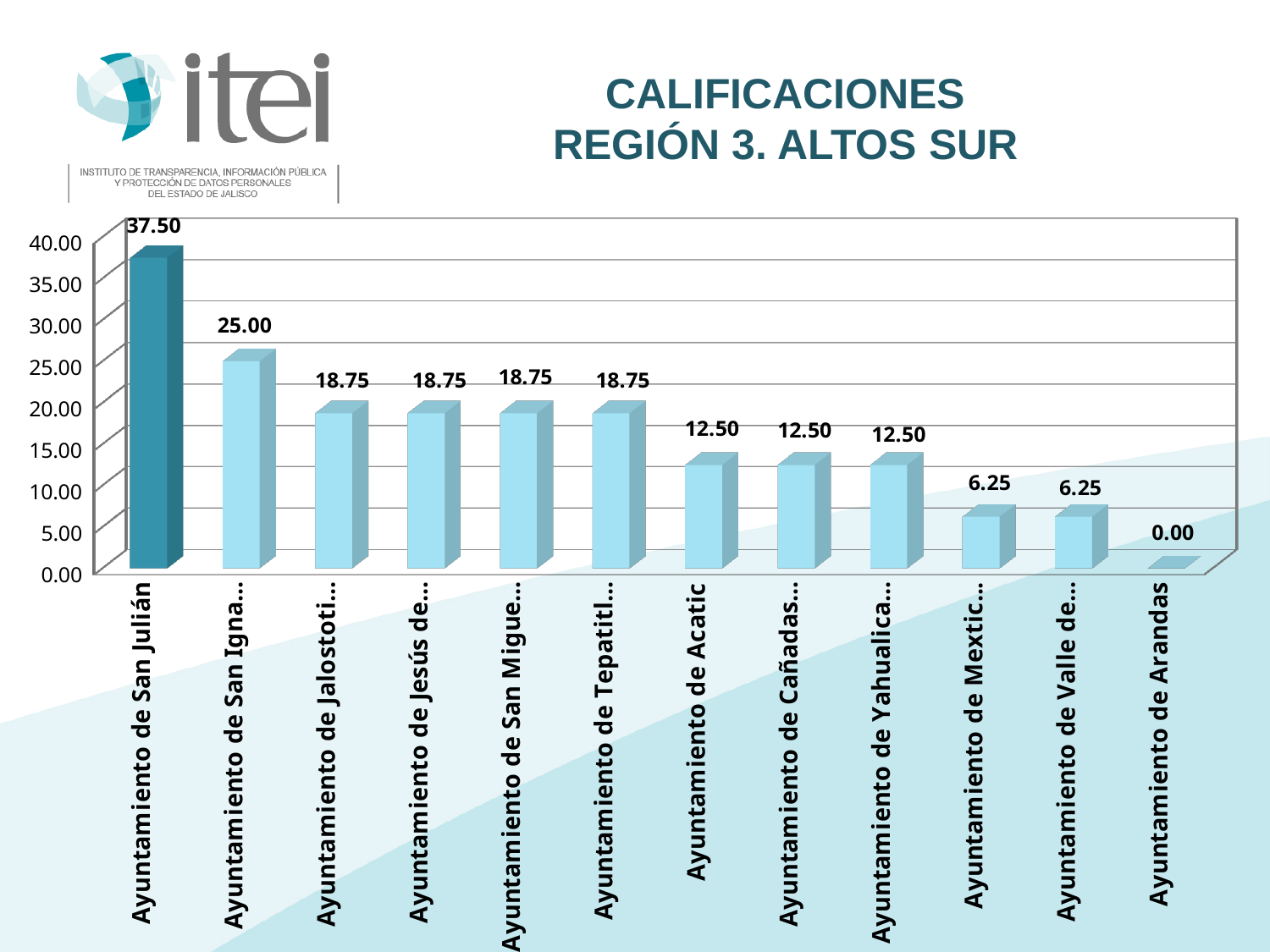
What is the difference between the values for Ayuntamiento de San Julián and Ayuntamiento de Acatic? 25.00 What is the value for Ayuntamiento de Acatic? 12.50 Which is larger, the value for Ayuntamiento de San Julián or the value for Ayuntamiento de Acatic? Ayuntamiento de San Julián What kind of chart is shown on the slide? bar chart What is the value for Ayuntamiento de San Julián? 37.50 Which category has the highest value? Ayuntamiento de San Julián Is the value for Ayuntamiento de Acatic greater or less than 20.00? less How many categories are shown on the x axis? 12 Do the values rise or fall from left to right along the x axis? fall Which category has the lowest value? Ayuntamiento de Arandas What is the title shown above the chart? CALIFICACIONES REGIÓN 3. ALTOS SUR What is the value for Ayuntamiento de Arandas? 0.00